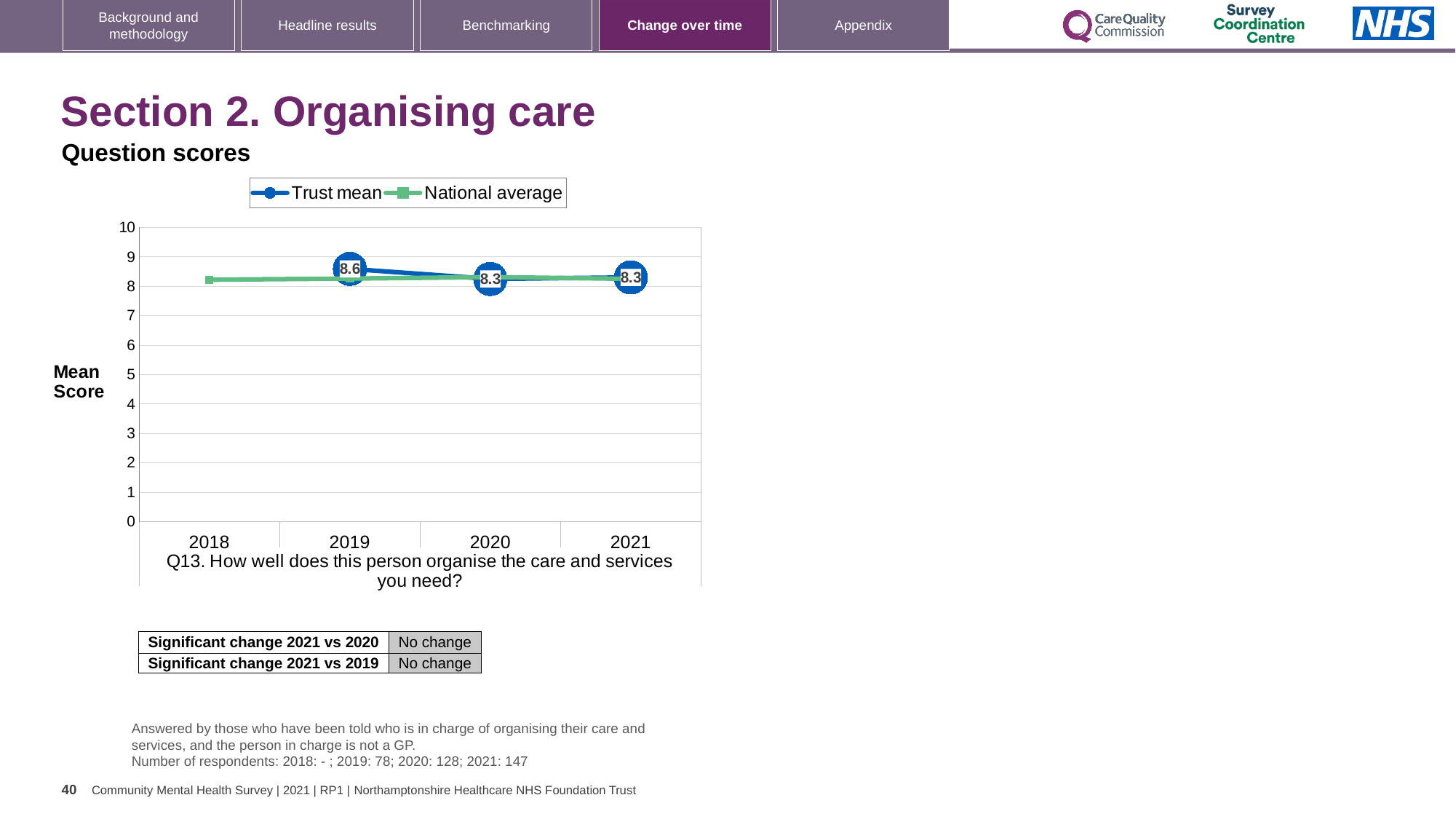
Which is larger, the Trust mean in 2019 or in 2021? 2019 What is the title of the y axis? Mean Score What is the Trust mean for 2019? 8.6 Is the National average for 2018 greater or less than 5? greater How many series does the legend list? 2 What is the Trust mean for 2020? 8.3 What is the difference between the Trust mean in 2019 and in 2020? 0.3 What is the Trust mean for 2021? 8.3 In which year is the Trust mean highest? 2019 What kind of chart is shown on the slide? line chart Does the Trust mean rise or fall from 2019 to 2021? fall How many years are shown on the x axis? 4